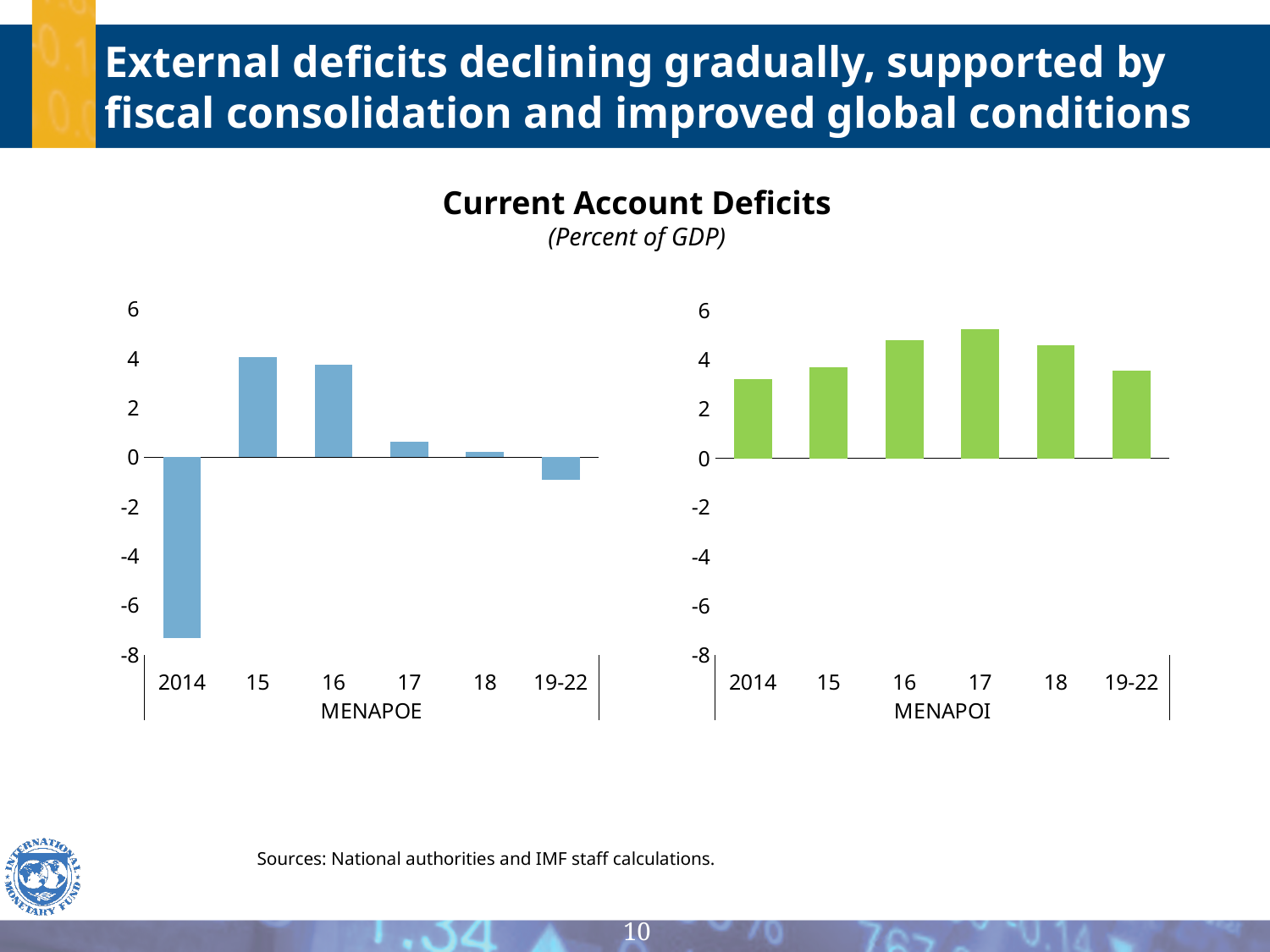
In the MENAPOE chart, which period has the lowest value? 2014 In the MENAPOE chart, do the values rise or fall from 15 to 19-22? fall In the MENAPOE chart, is the value for 15 greater or less than 2? greater In the MENAPOE chart, which is larger, the value for 15 or the value for 17? 15 In the MENAPOI chart, which period has the highest value? 17 What is the title shown above the two charts? Current Account Deficits In the MENAPOI chart, is the value for 17 greater or less than 4? greater How many bars are plotted in the MENAPOI chart on the right? 6 What kind of chart is the MENAPOE chart on the left? bar chart In the MENAPOI chart, is the value for 2014 greater or less than 4? less In the MENAPOI chart, which period has the lowest value? 2014